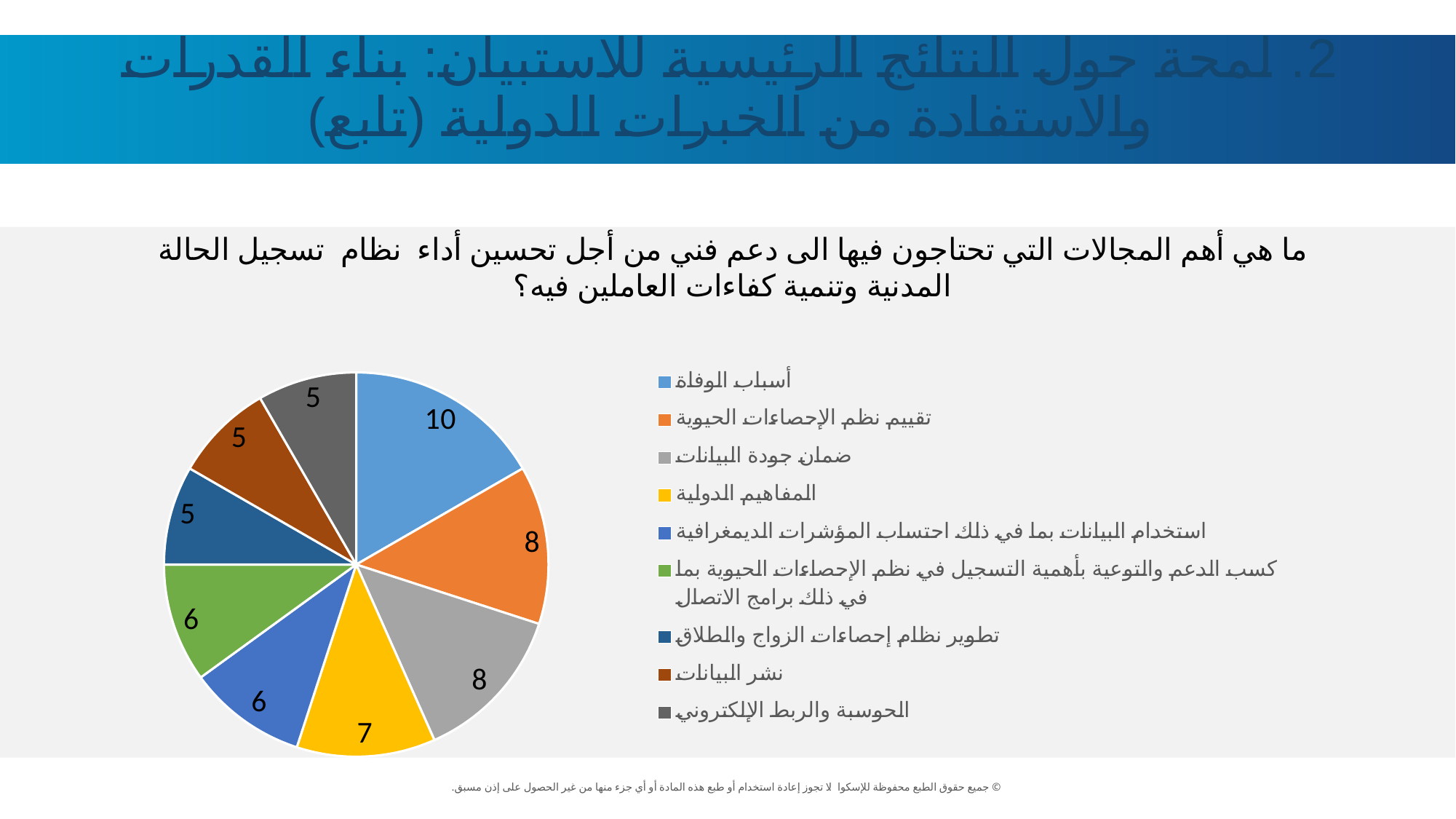
What is the value for ضمان جودة البيانات in the pie chart? 8 How many categories (slices) does the pie chart have? 9 What is the value for أسباب الوفاة in the pie chart? 10 What is the sum of all the values shown in the pie chart? 60 Which is larger: the value for تقييم نظم الإحصاءات الحيوية or the value for الحوسبة والربط الإلكتروني? تقييم نظم الإحصاءات الحيوية What is the difference between the values for أسباب الوفاة and المفاهيم الدولية? 3 What is the value for نشر البيانات in the pie chart? 5 What type of chart is shown on the slide? pie chart Which category has the largest slice in the pie chart? أسباب الوفاة What colour is the slice for المفاهيم الدولية in the pie chart? yellow What is the value for المفاهيم الدولية in the pie chart? 7 What share of the pie does أسباب الوفاة represent? 16.7%